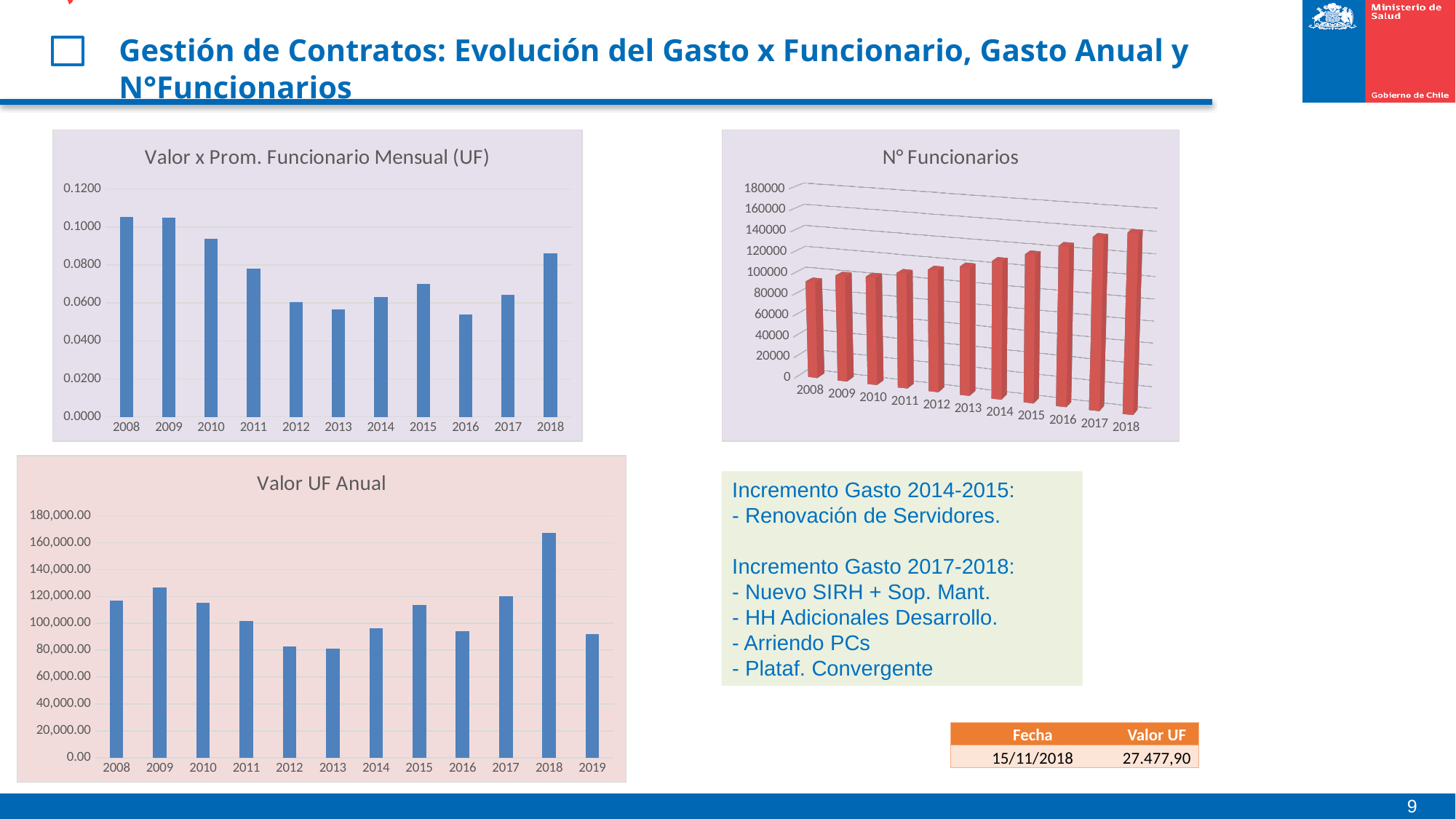
In the "Valor UF Anual" chart, is the value for 2013 greater or less than 100,000.00? less In the "N° Funcionarios" chart, do the values generally rise or fall from 2008 to 2018? rise What type of chart is "Valor UF Anual"? bar chart In the "N° Funcionarios" chart, which year has the highest value? 2018 In the "N° Funcionarios" chart, which year has the lowest value? 2008 In the "Valor UF Anual" chart, which year has the highest value? 2018 In the "Valor UF Anual" chart, which is larger, the value for 2016 or the value for 2017? 2017 In the "Valor x Prom. Funcionario Mensual (UF)" chart, is the value for 2018 greater or less than 0.0800? greater In the "Valor UF Anual" chart, is the value for 2018 greater or less than 160,000.00? greater How many bars are in the "N° Funcionarios" chart? 11 How many years are shown on the x axis of the "Valor UF Anual" chart? 12